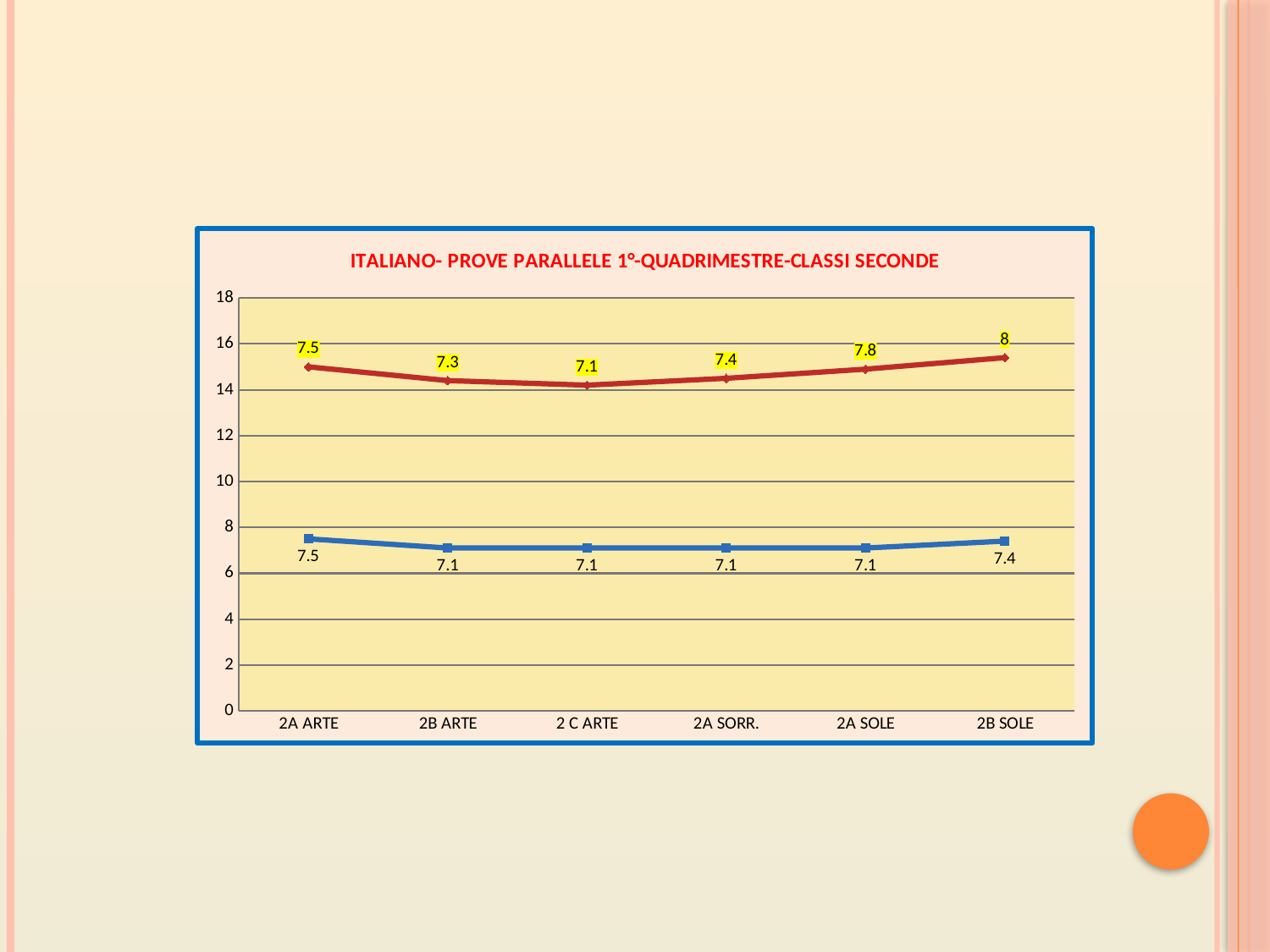
What is the data label of the red line for 2B SOLE? 8 What is the difference between the red line's data labels for 2B SOLE and 2A ARTE? 0.5 How many classes (categories) are shown on the x axis? 6 Which class has the highest data label on the blue line? 2A ARTE What is the data label of the blue line for 2A ARTE? 7.5 Is the plotted value of the blue line for 2B ARTE greater or less than 8? less What kind of chart is shown on the slide? line chart What is the data label of the red line for 2 C ARTE? 7.1 On the red line, which has the larger data label: 2A SOLE or 2A SORR.? 2A SOLE What is the title of the chart? ITALIANO- PROVE PARALLELE 1°-QUADRIMESTRE-CLASSI SECONDE What is the data label of the red line for 2A SOLE? 7.8 Which class has the highest data label on the red line? 2B SOLE